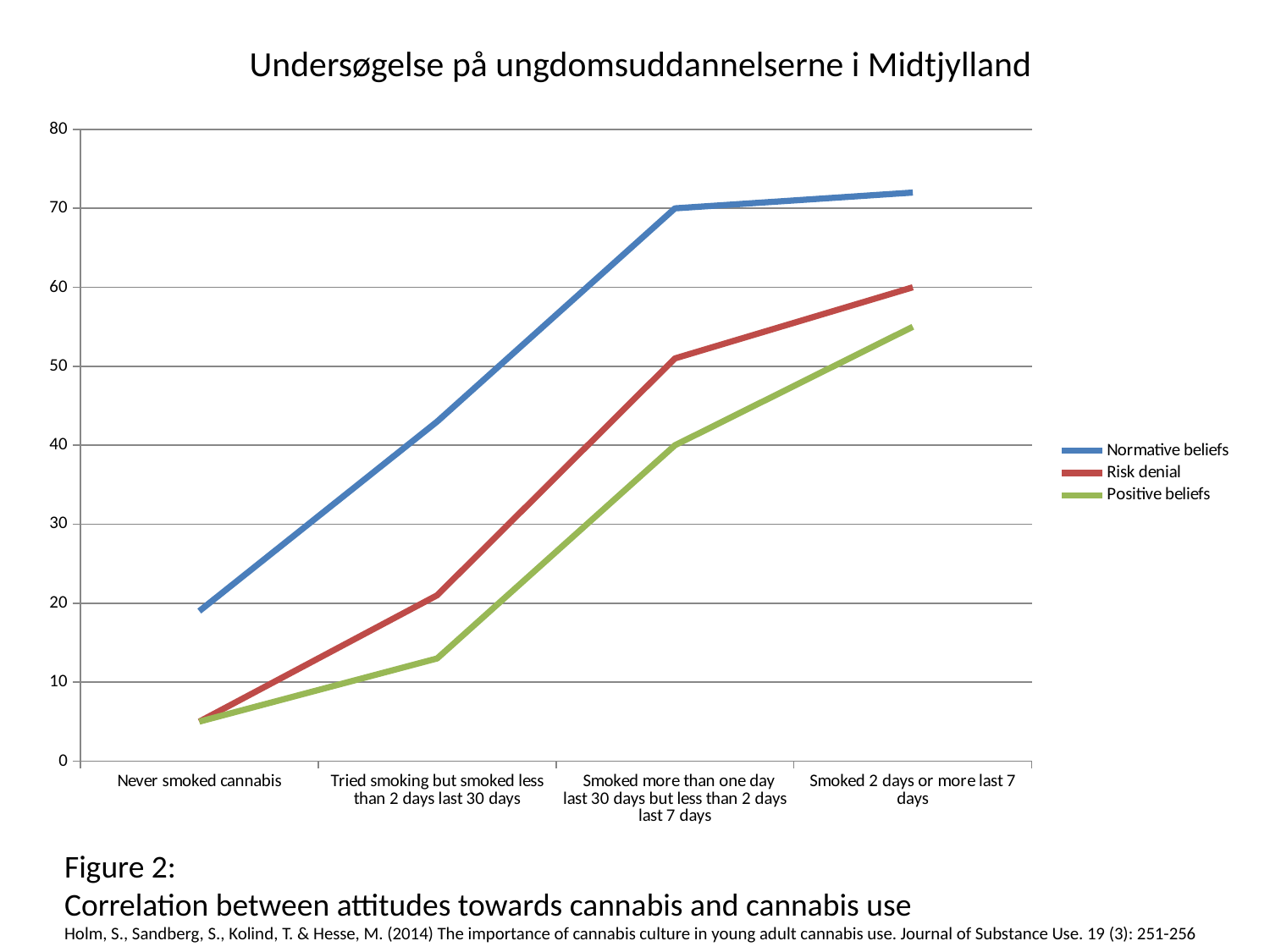
How many series does the legend list? 3 Which series is shown in blue in the legend? Normative beliefs Which series has the lowest value for 'Tried smoking but smoked less than 2 days last 30 days'? Positive beliefs Is the value for Risk denial at 'Smoked 2 days or more last 7 days' greater or less than 50? greater Is the value for Normative beliefs at 'Never smoked cannabis' greater or less than 30? less Is the value for Positive beliefs at 'Smoked more than one day last 30 days but less than 2 days last 7 days' greater or less than 30? greater Which series has the highest value for 'Smoked 2 days or more last 7 days'? Normative beliefs Which is larger for 'Smoked more than one day last 30 days but less than 2 days last 7 days': Risk denial or Positive beliefs? Risk denial How many categories are shown on the x axis? 4 What kind of chart is shown on the slide? line chart What is the title of the chart? Undersøgelse på ungdomsuddannelserne i Midtjylland Do the values for Normative beliefs rise or fall from left to right along the x axis? rise